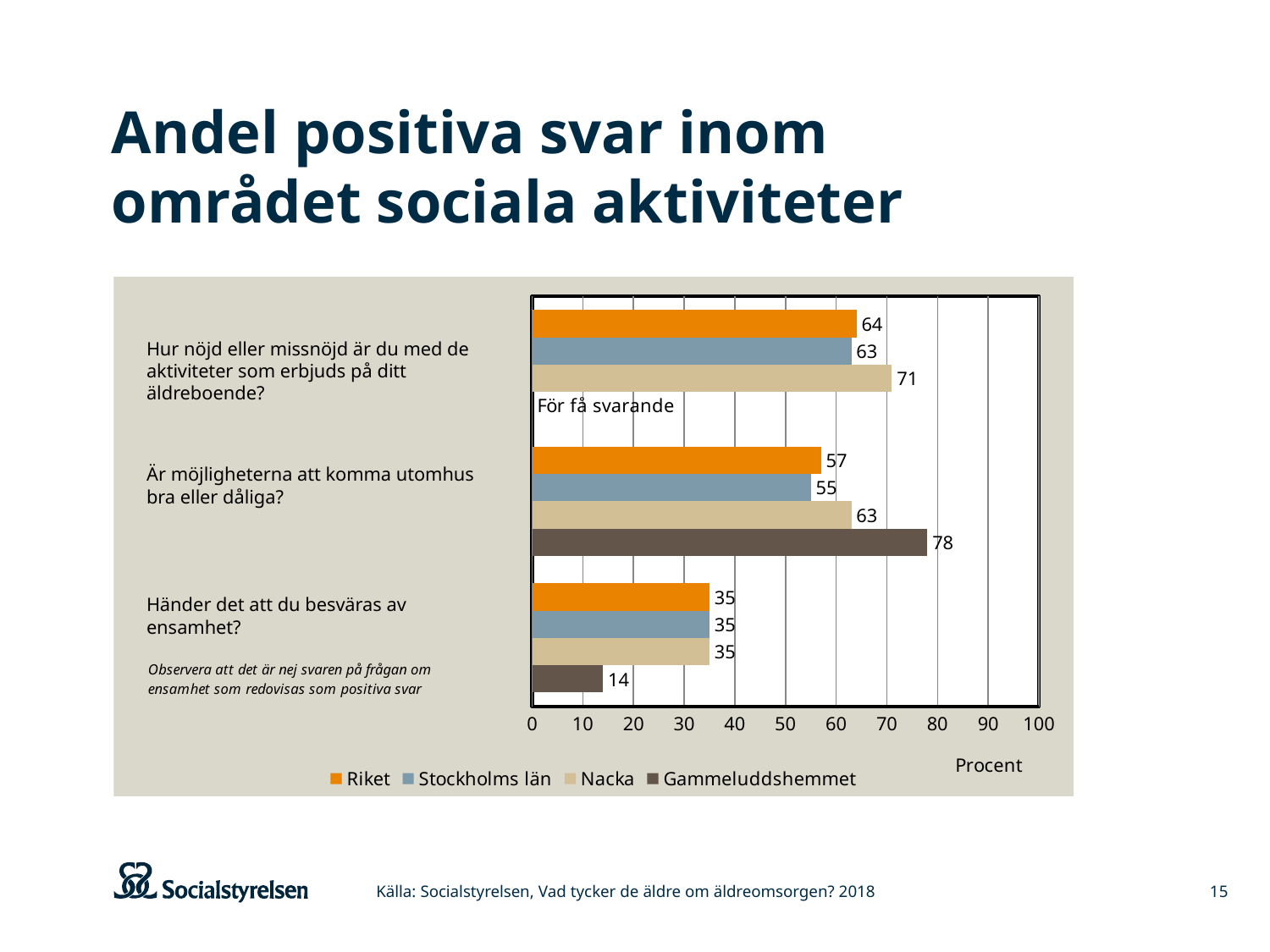
What is the value for Gammeluddshemmet on the question "Händer det att du besväras av ensamhet?"? 14 What is shown instead of a bar for Gammeluddshemmet on the question "Hur nöjd eller missnöjd är du med de aktiviteter som erbjuds på ditt äldreboende?"? För få svarande Which series has the highest value on the question "Är möjligheterna att komma utomhus bra eller dåliga?"? Gammeluddshemmet What is the value for Nacka on the question "Hur nöjd eller missnöjd är du med de aktiviteter som erbjuds på ditt äldreboende?"? 71 Which series has the lowest value on the question "Händer det att du besväras av ensamhet?"? Gammeluddshemmet How many series does the legend list? 4 What is the value for Stockholms län on the question "Är möjligheterna att komma utomhus bra eller dåliga?"? 55 What is the difference between the Nacka and Riket values on the question "Hur nöjd eller missnöjd är du med de aktiviteter som erbjuds på ditt äldreboende?"? 7 What is the label on the horizontal axis of the chart? Procent What is the value for Gammeluddshemmet on the question "Är möjligheterna att komma utomhus bra eller dåliga?"? 78 What kind of chart is shown on the slide? Bar chart Which is larger on the question "Är möjligheterna att komma utomhus bra eller dåliga?": the value for Riket or the value for Nacka? Nacka